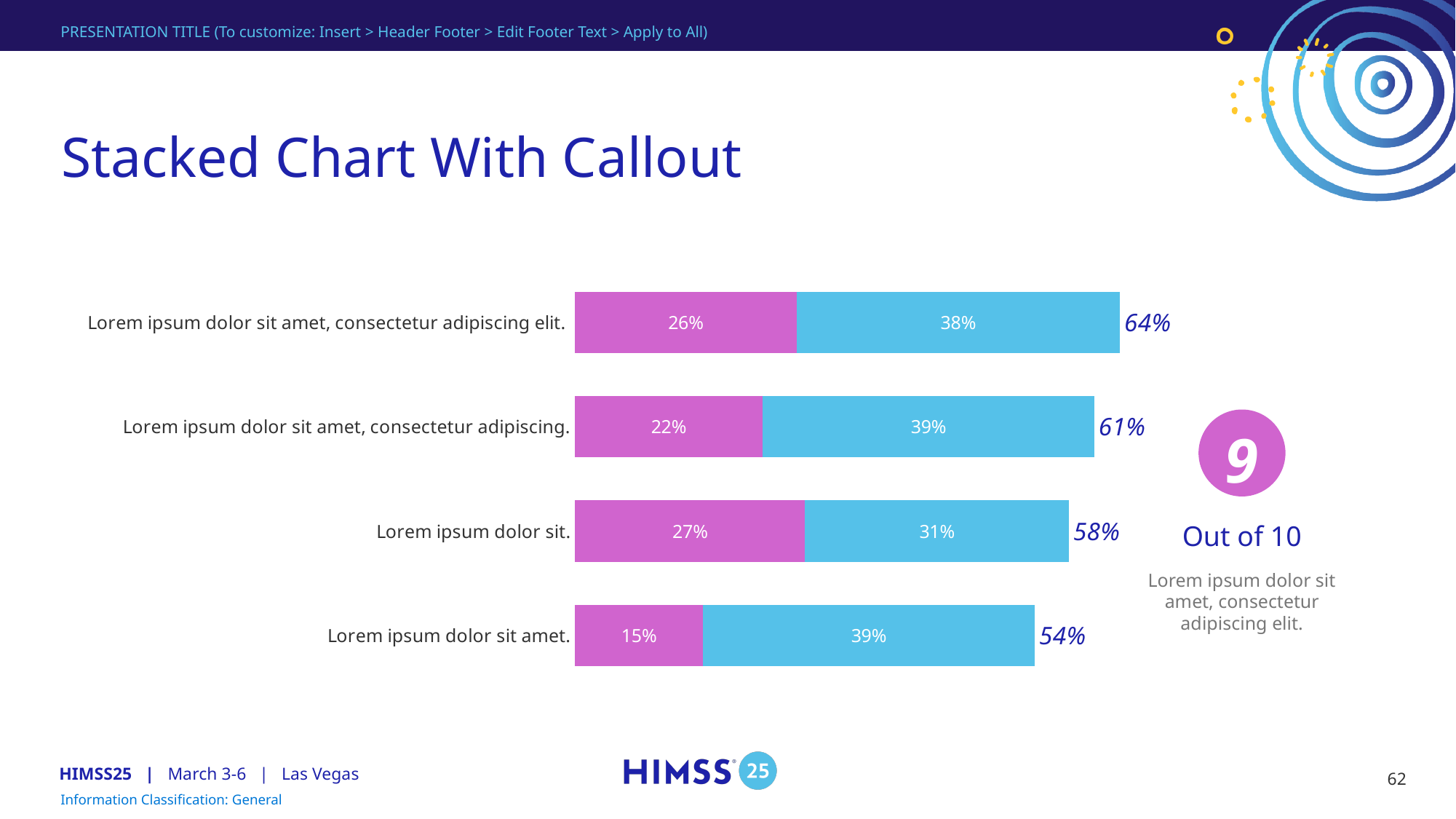
What number is shown in the pink circle callout next to the chart? 9 What is the value of the blue segment for the category "Lorem ipsum dolor sit."? 31% What is the total shown for the bar labelled "Lorem ipsum dolor sit amet."? 54% What is the title of the slide containing the chart? Stacked Chart With Callout Which category has the highest total? Lorem ipsum dolor sit amet, consectetur adipiscing elit. What type of chart is shown on the slide? Stacked bar chart How many categories (bars) does the chart show? 4 Which is larger: the pink segment for "Lorem ipsum dolor sit." or the pink segment for "Lorem ipsum dolor sit amet, consectetur adipiscing."? Lorem ipsum dolor sit. What is the total shown for the bar labelled "Lorem ipsum dolor sit amet, consectetur adipiscing elit."? 64% What is the difference between the totals of the top bar (64%) and the bottom bar (54%)? 10% What is the value of the pink segment for the category "Lorem ipsum dolor sit amet."? 15% Which category has the lowest total? Lorem ipsum dolor sit amet.